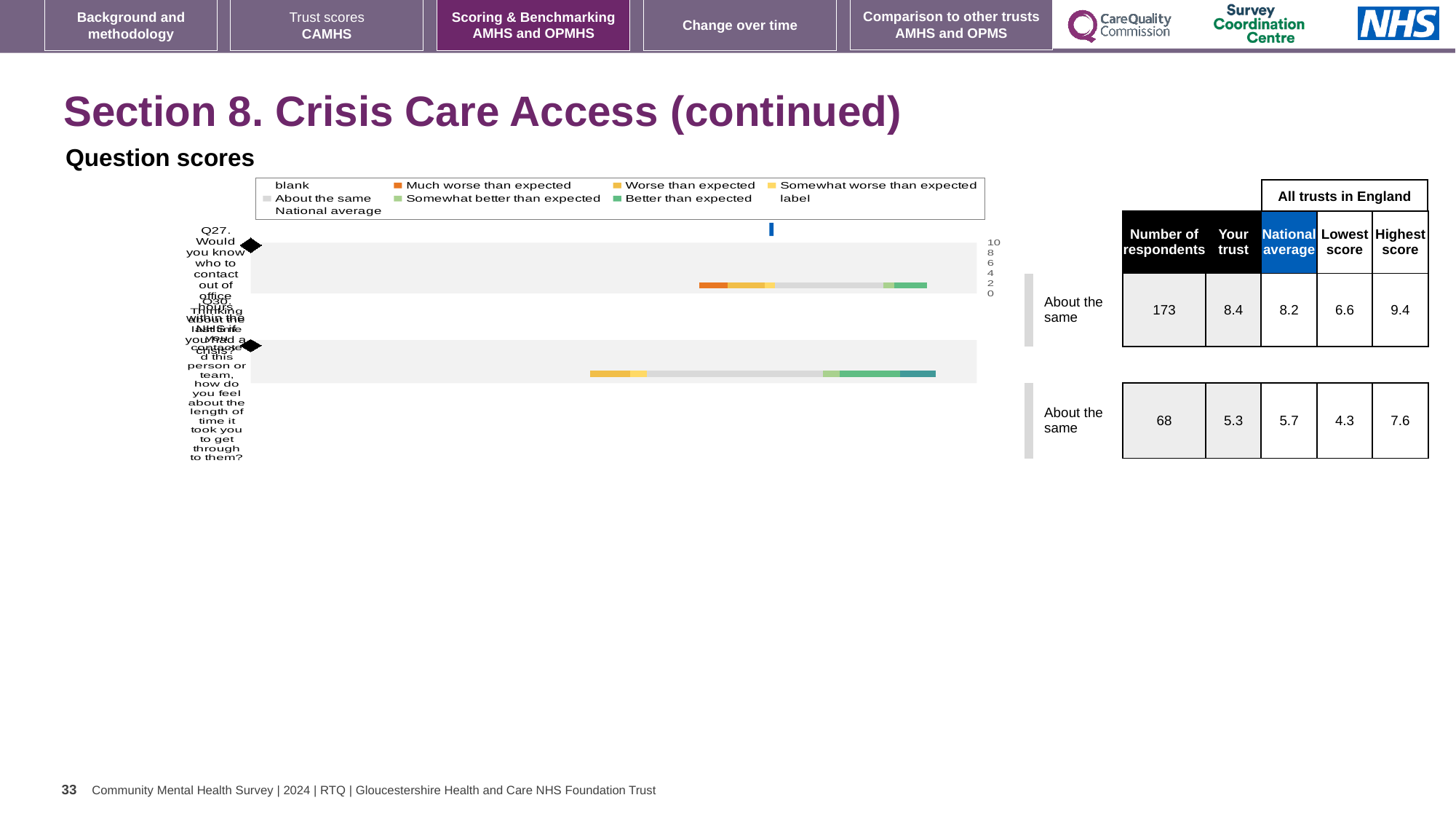
How many questions (categories) are plotted in the question scores chart? 2 In the table beside the chart, how many respondents answered Q27 (would you know who to contact out of office hours)? 173 What benchmark category is shown next to the chart for Q30? About the same For Q27, what is the difference between the highest score (9.4) and the lowest score (6.6) across all trusts in England? 2.8 What is the highest value shown on the chart's score axis? 10 For Q27, which is larger: the 'Your trust' score or the national average? Your trust In the table beside the chart, what is the national average for Q30 (length of time it took to get through)? 5.7 In the table beside the chart, what is the 'Your trust' score for Q27? 8.4 In the chart legend, what colour represents 'Much worse than expected'? orange In the table beside the chart, what is the lowest score across all trusts in England for Q30? 4.3 What kind of chart is used to show the question scores on this slide? bar chart For Q30, which is larger: the 'Your trust' score or the national average? National average